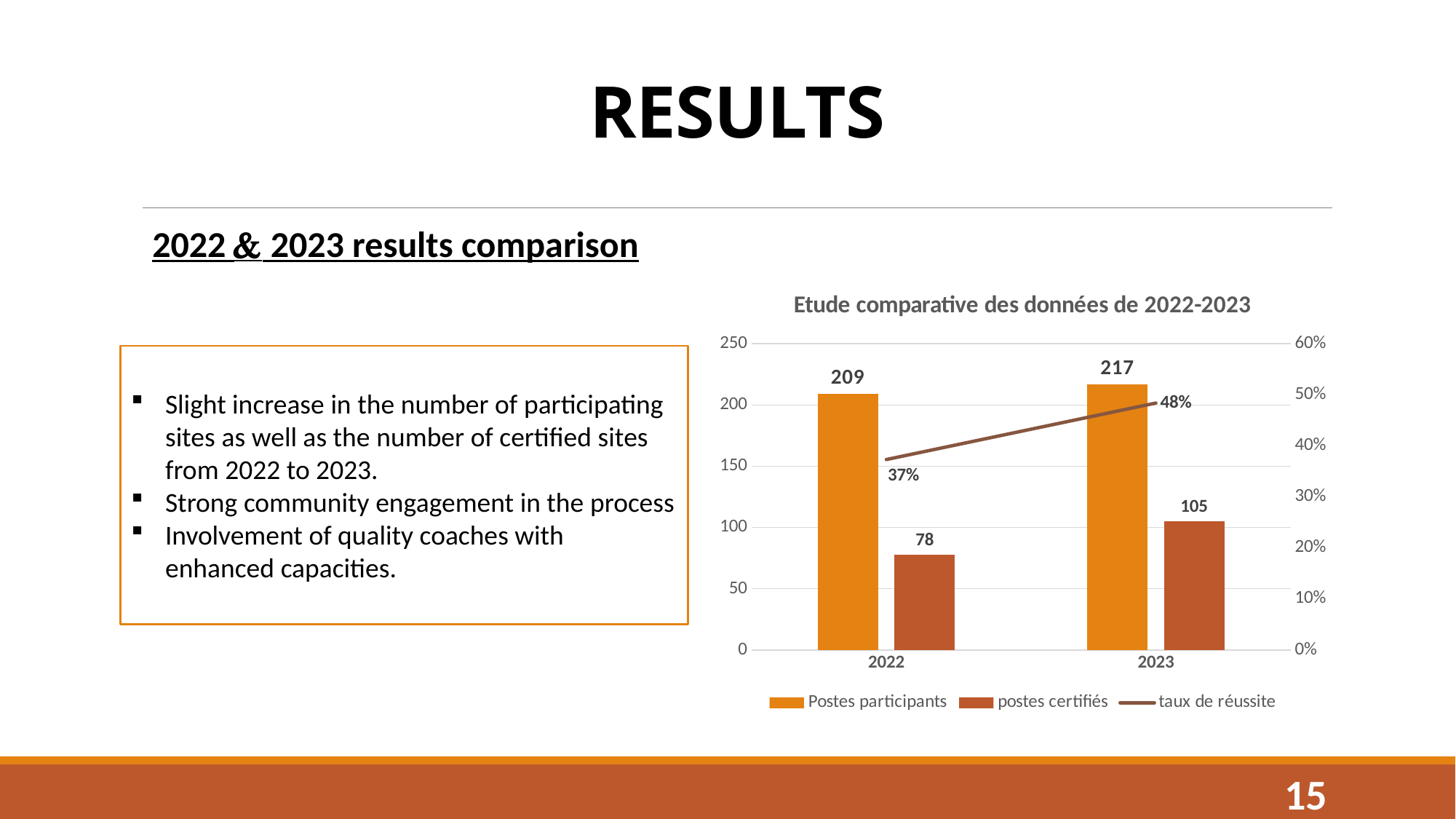
What is the taux de réussite for 2023? 48% Which year has the higher value for postes certifiés? 2023 What is the difference in postes certifiés between 2023 and 2022? 27 How many series does the legend list? 3 What is the difference in Postes participants between 2023 and 2022? 8 Does the taux de réussite rise or fall from 2022 to 2023? rise What is the value of Postes participants for 2022? 209 How many years are shown on the x axis? 2 What is the title of the chart? Etude comparative des données de 2022-2023 What is the value of postes certifiés for 2023? 105 What is the taux de réussite for 2022? 37% Is the value for postes certifiés in 2022 greater or less than 100? less